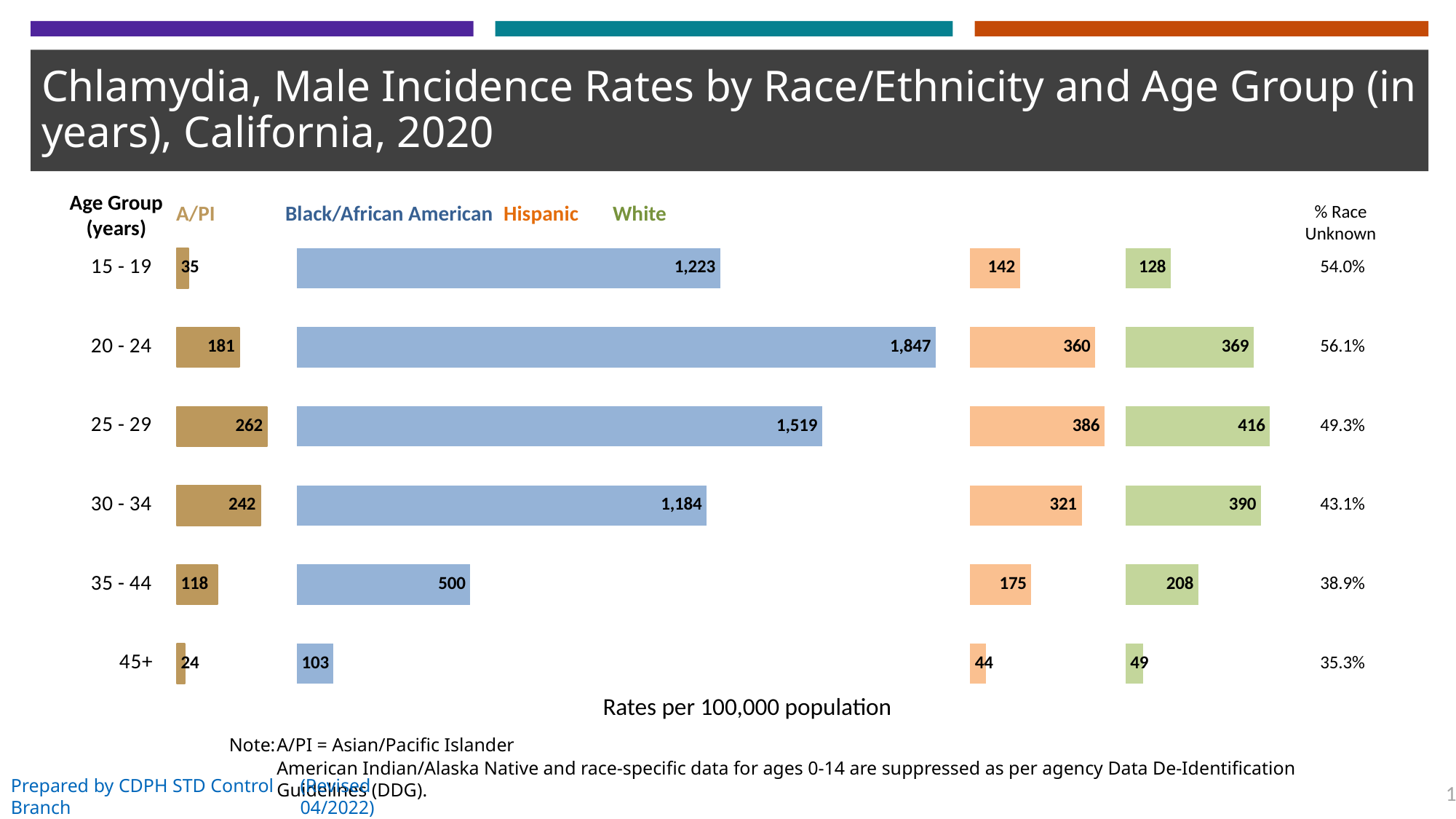
What unit are the rates in the chart expressed in? Rates per 100,000 population How many race/ethnicity series does the chart show? 4 What is the % Race Unknown for the 15 - 19 age group? 54.0% What kind of chart is shown on the slide? Bar chart What is the difference between the Black/African American and Hispanic rates for males aged 30 - 34? 863 How many age groups are shown in the chart? 6 What is the chlamydia incidence rate for A/PI males aged 45+? 24 Which age group has the lowest chlamydia incidence rate among Black/African American males? 45+ For males aged 35 - 44, which is larger: the White rate or the Hispanic rate? White Which age group has the highest chlamydia incidence rate among Hispanic males? 25 - 29 What is the chlamydia incidence rate for White males aged 25 - 29? 416 What is the chlamydia incidence rate for Black/African American males aged 20 - 24? 1,847